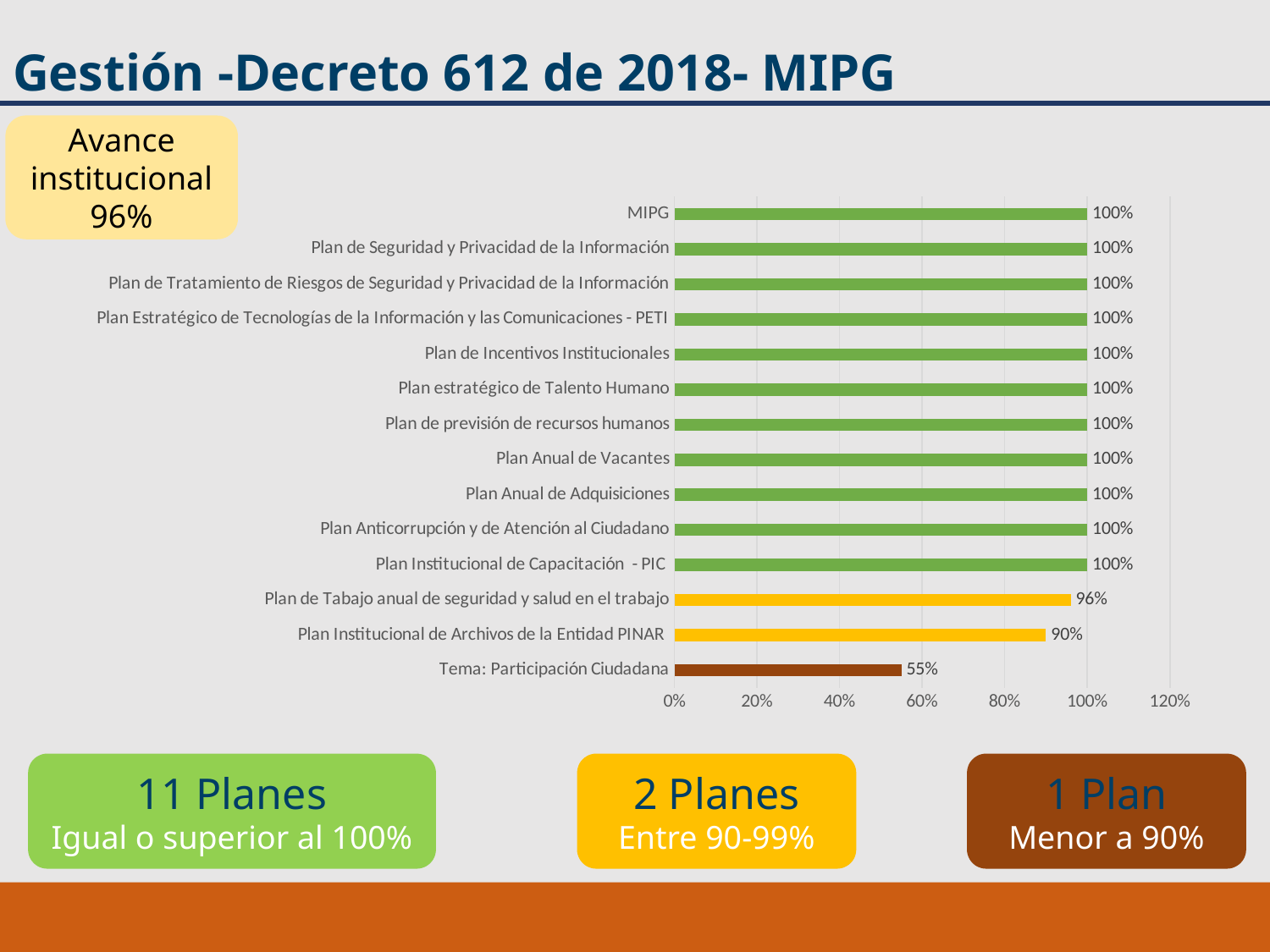
Which is larger, the value for Plan Institucional de Archivos de la Entidad PINAR or the value for Plan de Tabajo anual de seguridad y salud en el trabajo? Plan de Tabajo anual de seguridad y salud en el trabajo Which category has the lowest value? Tema: Participación Ciudadana How many categories in the chart have a value of 100%? 11 What is the value for Plan de Tabajo anual de seguridad y salud en el trabajo? 96% What is the value for Tema: Participación Ciudadana? 55% How many categories are shown in the chart? 14 What is the difference between the value for Plan Institucional de Archivos de la Entidad PINAR and the value for Tema: Participación Ciudadana? 35% What is the value for Plan Anual de Adquisiciones? 100% What is the difference between the value for MIPG and the value for Plan de Tabajo anual de seguridad y salud en el trabajo? 4% What kind of chart is shown on the slide? bar chart What is the value for Plan Institucional de Archivos de la Entidad PINAR? 90% Is the value for Tema: Participación Ciudadana greater or less than 60%? less